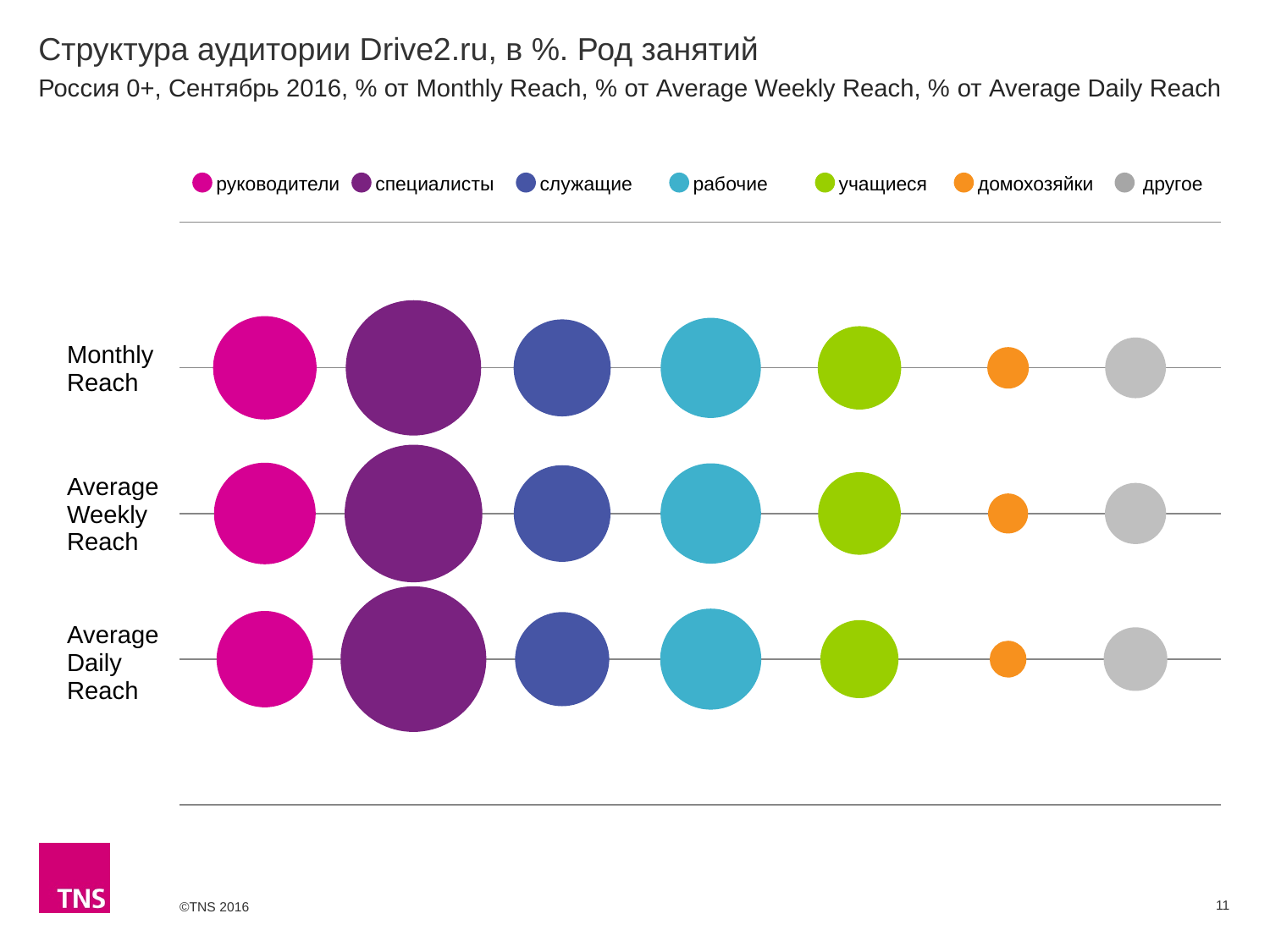
Which occupation category has the smallest bubble in the Monthly Reach row? домохозяйки In the Average Daily Reach row, which bubble is larger: другое or домохозяйки? другое How many reach rows (Monthly Reach, Average Weekly Reach, Average Daily Reach) are plotted on the chart? 3 In the Monthly Reach row, which bubble is larger: руководители or служащие? руководители Which occupation category has the largest bubble in the Monthly Reach row? специалисты What kind of chart is shown on the slide? bubble chart How many occupation categories does the legend list? 7 Which occupation category has the smallest bubble in the Average Weekly Reach row? домохозяйки In the Average Weekly Reach row, which bubble is larger: рабочие or учащиеся? рабочие Which occupation category has the largest bubble in the Average Daily Reach row? специалисты What colour is used for the специалисты category in the legend? purple What is the title of the chart on the slide? Структура аудитории Drive2.ru, в %. Род занятий